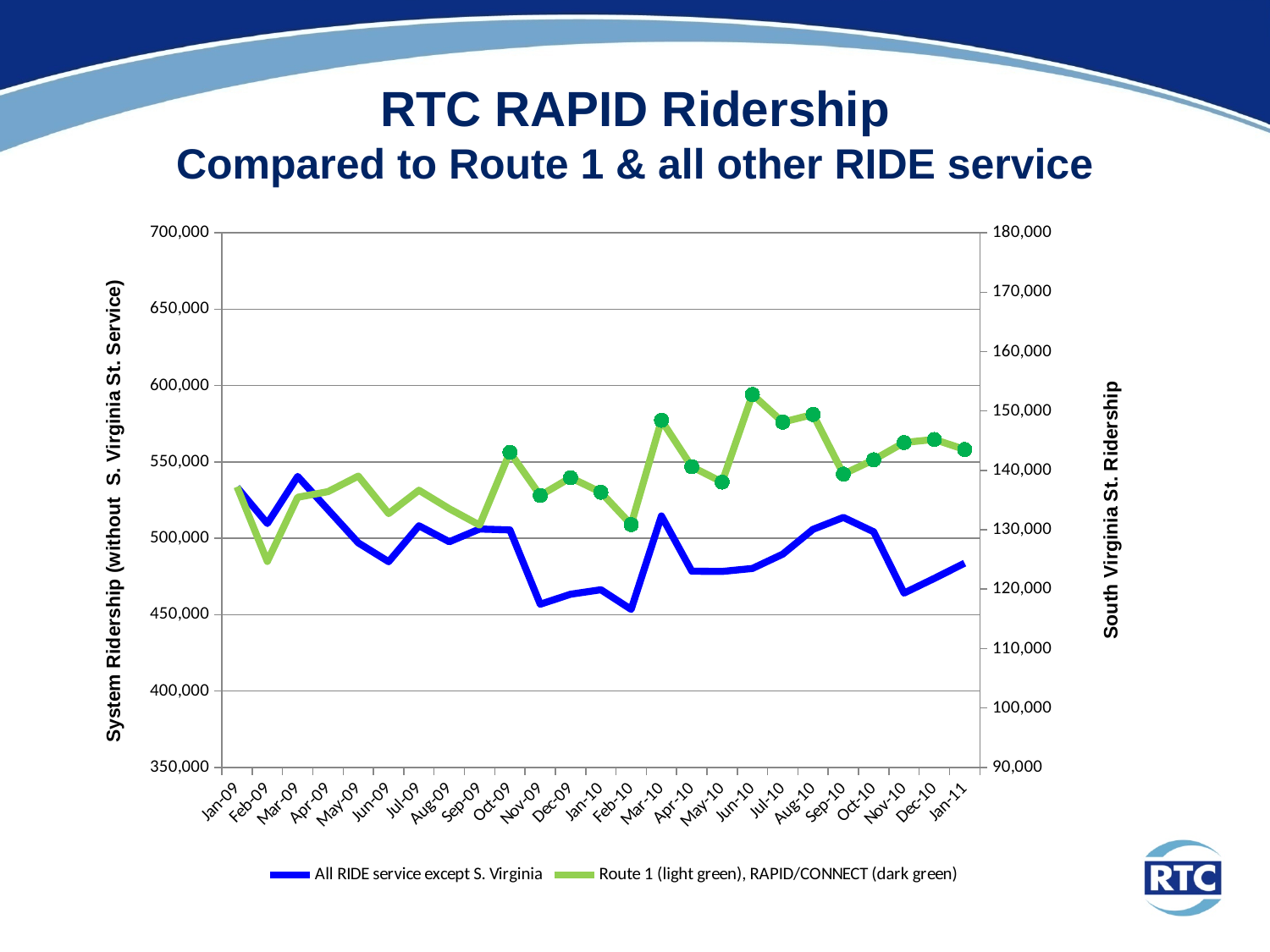
What kind of chart is shown on the slide? Line chart Is the value for the green Route 1 / RAPID/CONNECT line in Feb-09 greater or less than 130,000? less What is the title of the right-hand vertical axis? South Virginia St. Ridership In which month does the Route 1 / RAPID/CONNECT (green) line reach its lowest value? Feb-09 How many months are plotted along the x axis, from Jan-09 to Jan-11? 25 Does the All RIDE service except S. Virginia line rise or fall from Oct-09 to Nov-09? Fall For All RIDE service except S. Virginia, which month has the larger value, Feb-10 or Mar-10? Mar-10 Is the value for All RIDE service except S. Virginia in Nov-09 greater or less than 500,000? less Is the value for All RIDE service except S. Virginia in Mar-09 greater or less than 500,000? greater How many series does the legend list? 2 In which month does the Route 1 / RAPID/CONNECT (green) line reach its highest value? Jun-10